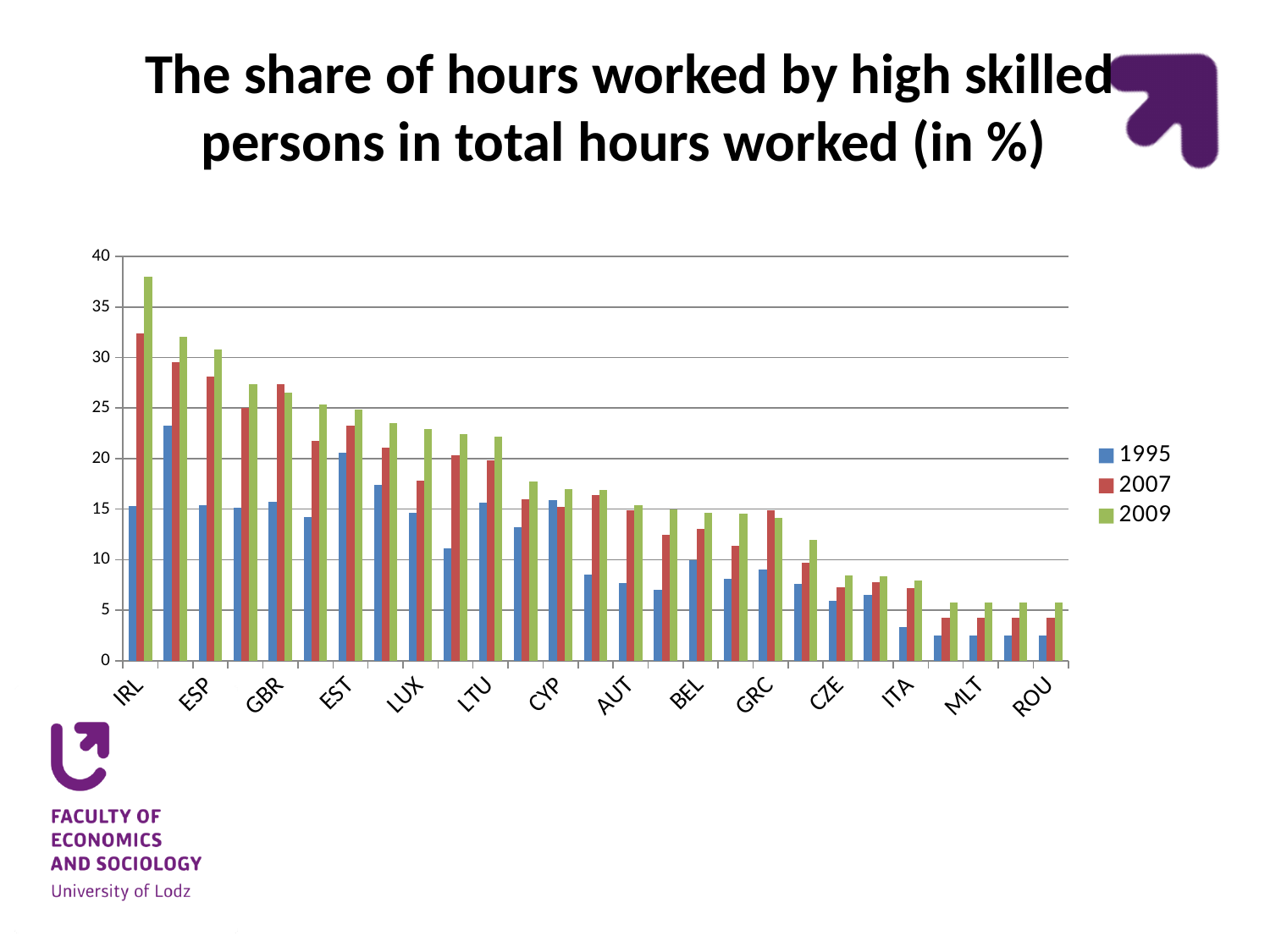
Is the 1995 value for ROU greater or less than 5? less What is the title of the chart? The share of hours worked by high skilled persons in total hours worked (in %) How many series does the legend list? 3 Is the 2009 value for ROU greater or less than 5? greater Which country has the highest value for 2009? IRL Do the 2009 values generally rise or fall moving from left to right along the x axis? fall What kind of chart is shown on the slide? bar chart What colour represents the 2009 series in the legend? green Is the 2009 value for IRL greater or less than 35? greater Which has the larger 2009 value, IRL or ESP? IRL For IRL, which year has the larger value, 1995 or 2009? 2009